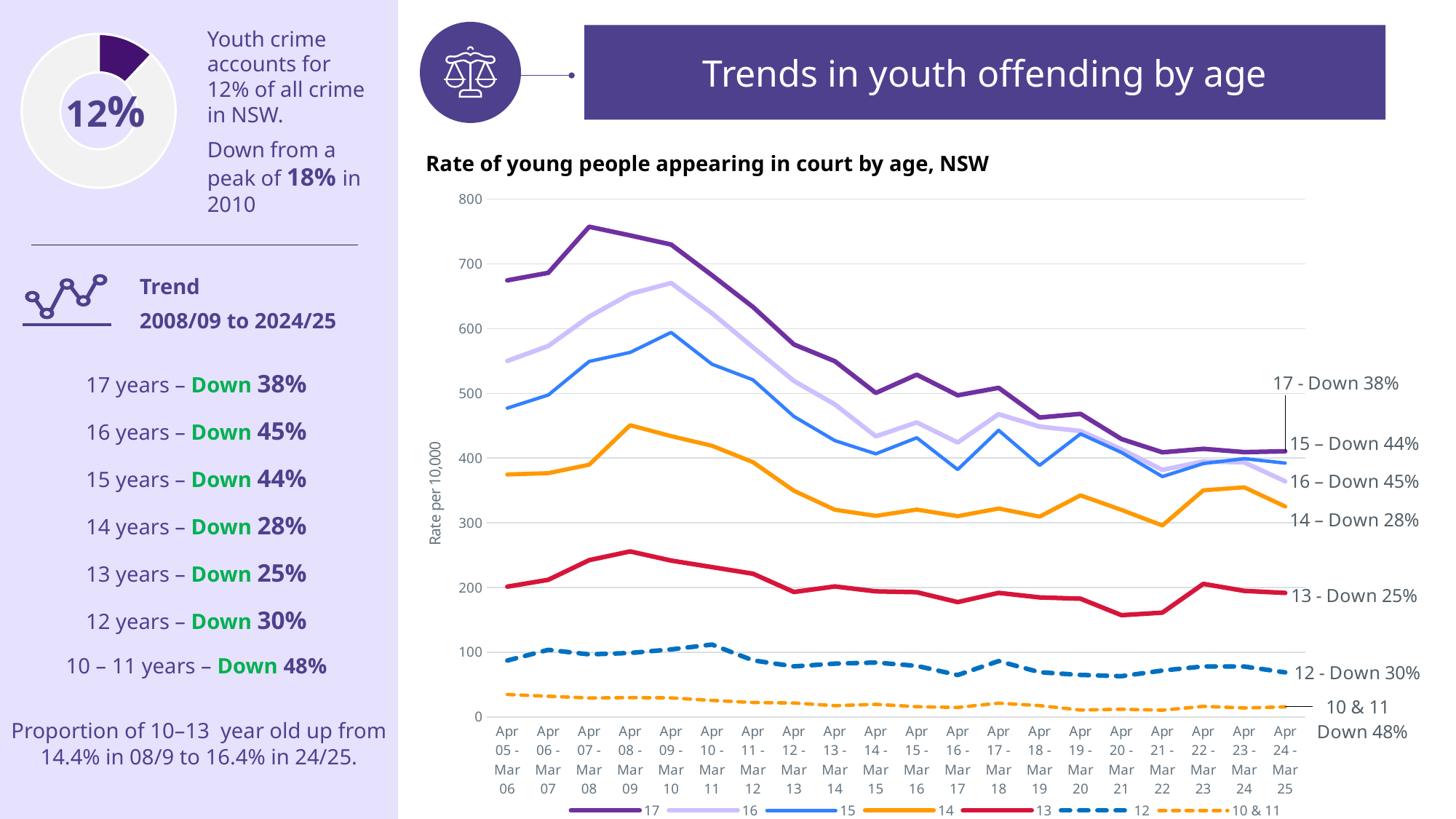
What kind of chart is 'Rate of young people appearing in court by age, NSW'? Line chart In the 'Rate of young people appearing in court by age, NSW' chart, what percentage change is annotated at the end of the line for 15 year olds? Down 44% In the 'Rate of young people appearing in court by age, NSW' chart, does the rate for 17 year olds rise or fall overall from Apr 05 - Mar 06 to Apr 24 - Mar 25? Fall In the 'Rate of young people appearing in court by age, NSW' chart, is the rate for 17 year olds in Apr 05 - Mar 06 greater or less than 600? greater In the 'Rate of young people appearing in court by age, NSW' chart, which age series has the lowest rate across the whole period? 10 & 11 How many series does the legend of the 'Rate of young people appearing in court by age, NSW' chart list? 7 In the 'Rate of young people appearing in court by age, NSW' chart, is the rate for 12 year olds in Apr 10 - Mar 11 greater or less than 200? less In the 'Rate of young people appearing in court by age, NSW' chart, is the rate for 13 year olds in Apr 08 - Mar 09 greater or less than 200? greater In the 'Rate of young people appearing in court by age, NSW' chart, which is higher in Apr 08 - Mar 09: the rate for 14 year olds or the rate for 13 year olds? 14 year olds What share of all crime in NSW does the donut chart on the left show youth crime accounts for? 12% In the 'Rate of young people appearing in court by age, NSW' chart, which age series has the highest rate in Apr 07 - Mar 08? 17 How many time periods are shown on the x axis of the 'Rate of young people appearing in court by age, NSW' chart? 20